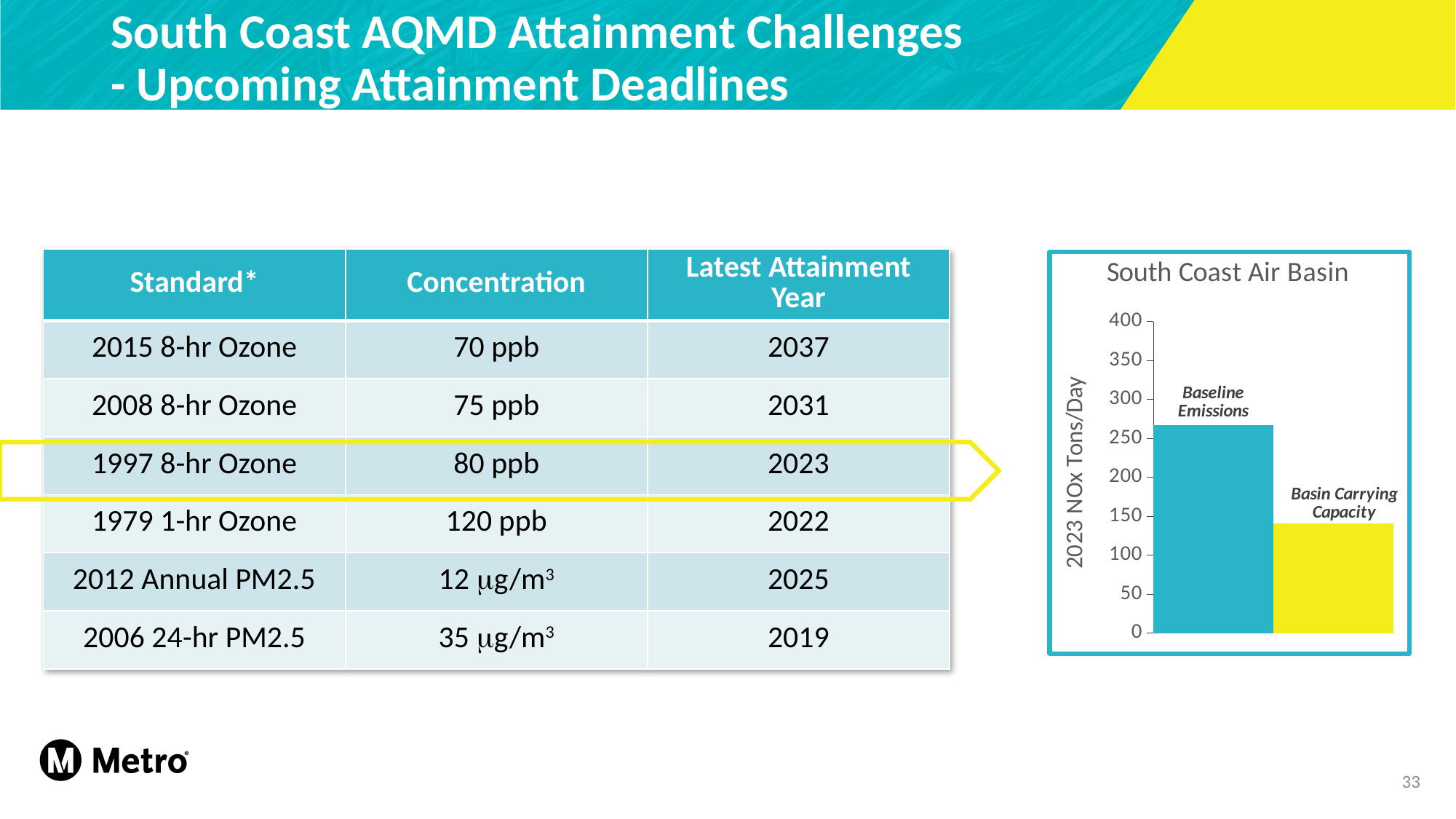
Is the value for Baseline Emissions greater or less than 250? greater What kind of chart is shown on the slide? bar chart Is the value for Baseline Emissions greater or less than 300? less What is the label on the vertical axis of the chart? 2023 NOx Tons/Day Which bar in the chart is the highest? Baseline Emissions How many bars are plotted in the chart? 2 Is the value for Basin Carrying Capacity greater or less than 100? greater What is the title of the chart? South Coast Air Basin Which bar in the chart is the lowest? Basin Carrying Capacity Which is larger in the chart, Baseline Emissions or Basin Carrying Capacity? Baseline Emissions What is the highest tick value shown on the vertical axis of the chart? 400